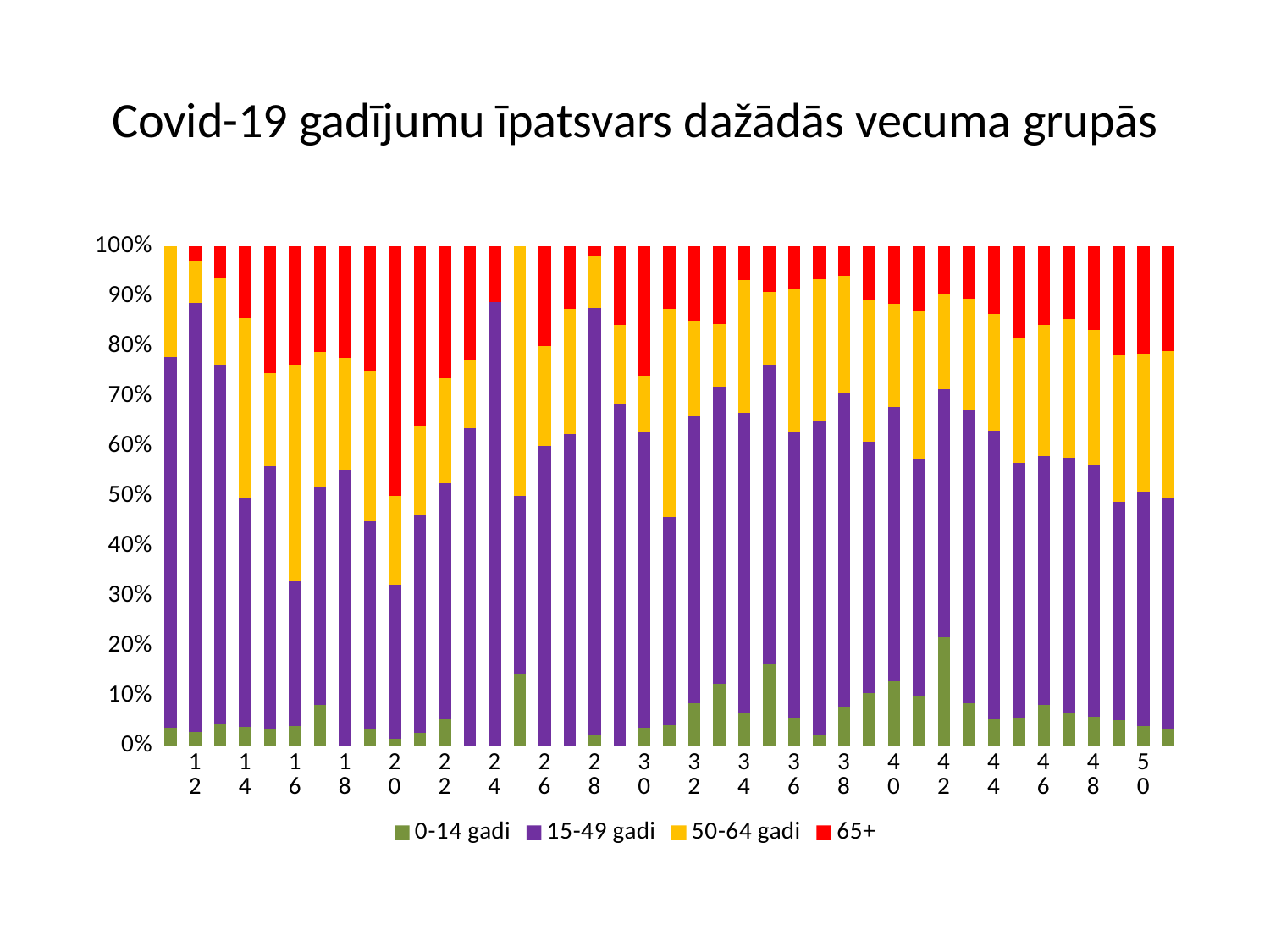
What kind of chart is shown on the slide? Stacked bar chart Which series is shown in red in the chart? 65+ Among the labeled weeks, which week has the smallest share for the 15-49 gadi series? 16 What is the title of the chart? Covid-19 gadījumu īpatsvars dažādās vecuma grupās Is the share of the 15-49 gadi series at week 12 greater or less than 80%? greater What does each stacked bar total? 100% Is the share of the 65+ series at week 20 greater or less than 40%? greater Among the labeled weeks, which week has the largest share for the 0-14 gadi series? 42 How many series does the legend list? 4 Among the labeled weeks, which week has the largest share for the 65+ series? 20 Which is larger: the share of the 0-14 gadi series at week 42 or at week 12? Week 42 Is the share of the 65+ series at week 38 greater or less than 10%? less